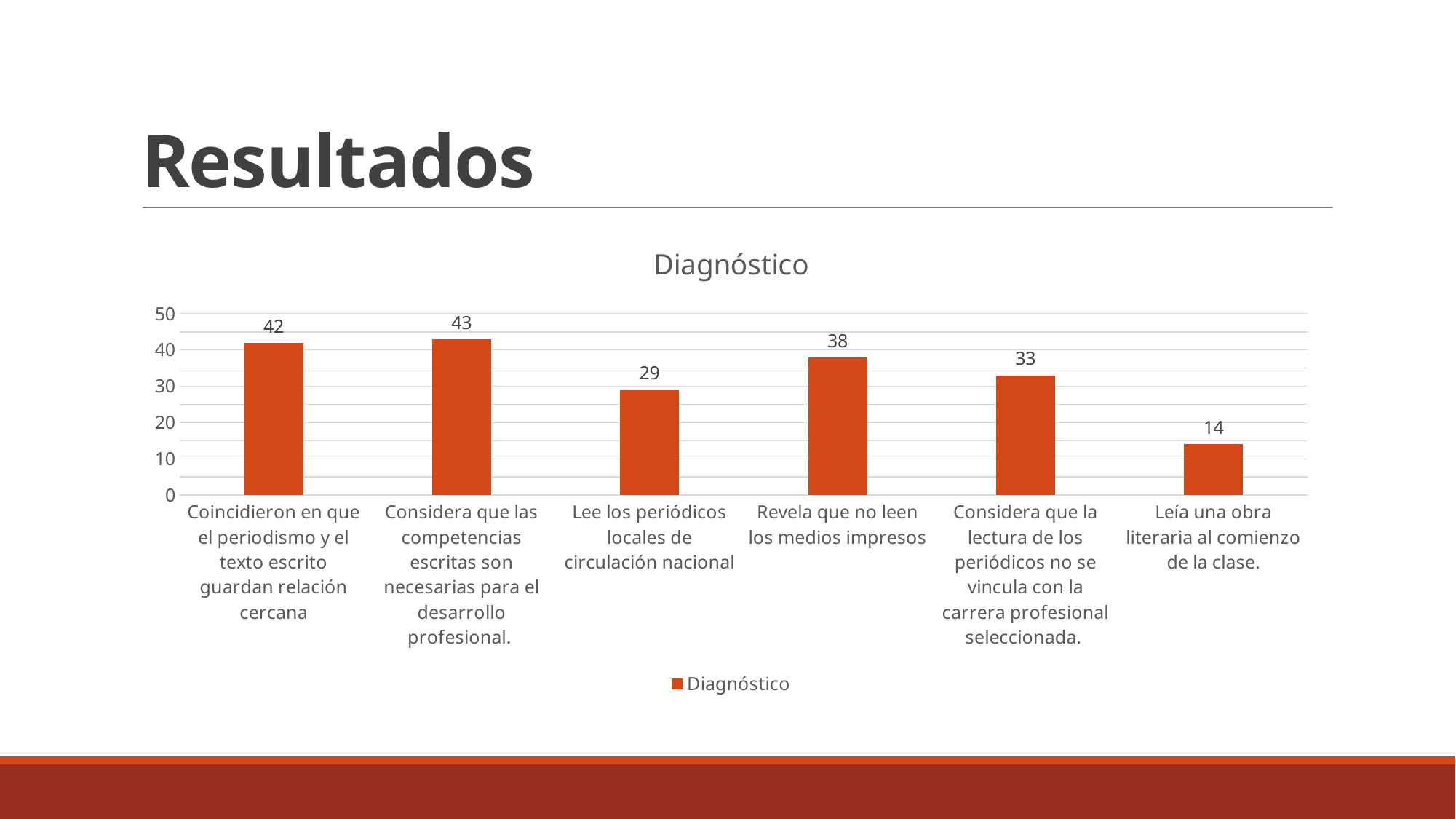
How many categories are shown in the chart? 6 What is the difference between the values for "Revela que no leen los medios impresos" and "Considera que la lectura de los periódicos no se vincula con la carrera profesional seleccionada."? 5 What is the value for "Revela que no leen los medios impresos"? 38 Is the value for "Considera que la lectura de los periódicos no se vincula con la carrera profesional seleccionada." greater or less than 40? less Which category has the highest value? Considera que las competencias escritas son necesarias para el desarrollo profesional. Which is larger: the value for "Coincidieron en que el periodismo y el texto escrito guardan relación cercana" or the value for "Revela que no leen los medios impresos"? Coincidieron en que el periodismo y el texto escrito guardan relación cercana What is the value for "Lee los periódicos locales de circulación nacional"? 29 What kind of chart is shown on the slide? bar chart Which category has the lowest value? Leía una obra literaria al comienzo de la clase. What is the value for "Leía una obra literaria al comienzo de la clase."? 14 What is the title of the chart? Diagnóstico How many series does the legend list? 1